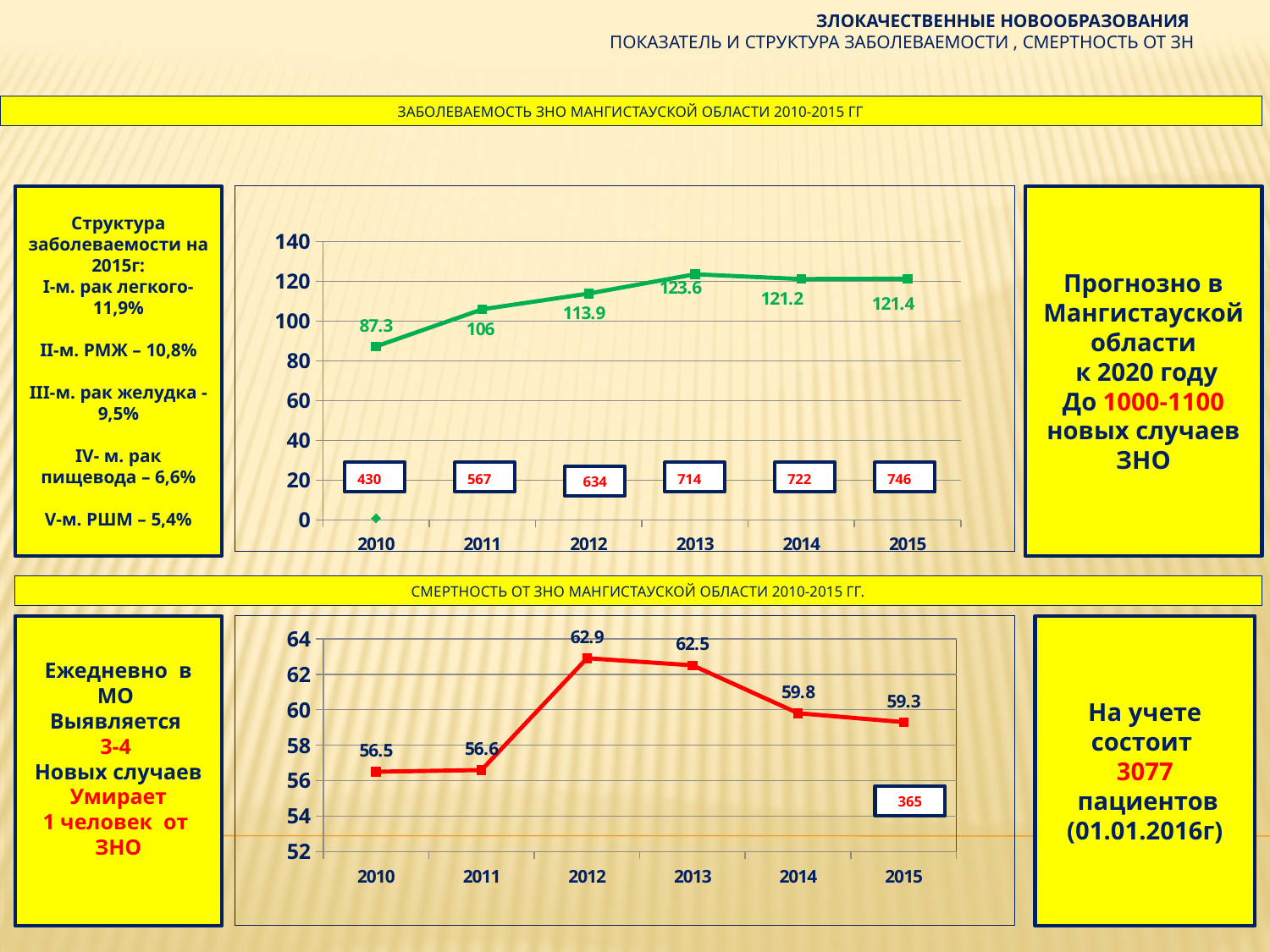
In the bottom chart (mortality, 2010-2015), which year has the highest value? 2012 In the top chart (incidence, 2010-2015), what is the difference between the 2012 value and the 2011 value? 7.9 In the top chart (incidence, 2010-2015), which year has the lowest value? 2010 In the top chart (incidence, 2010-2015), which year has the highest value? 2013 In the top chart (incidence, 2010-2015), what is the value for 2013? 123.6 In the bottom chart (mortality, 2010-2015), do the values rise or fall from 2012 to 2015? fall In the bottom chart (mortality, 2010-2015), what is the value for 2015? 59.3 In the top chart (incidence, 2010-2015), how many years are plotted on the x axis? 6 In the bottom chart (mortality, 2010-2015), which is larger, the value for 2013 or the value for 2014? 2013 In the top chart (incidence, 2010-2015), what is the value for 2010? 87.3 In the bottom chart (mortality, 2010-2015), what is the value for 2012? 62.9 What kind of chart is the top chart (incidence, 2010-2015)? line chart